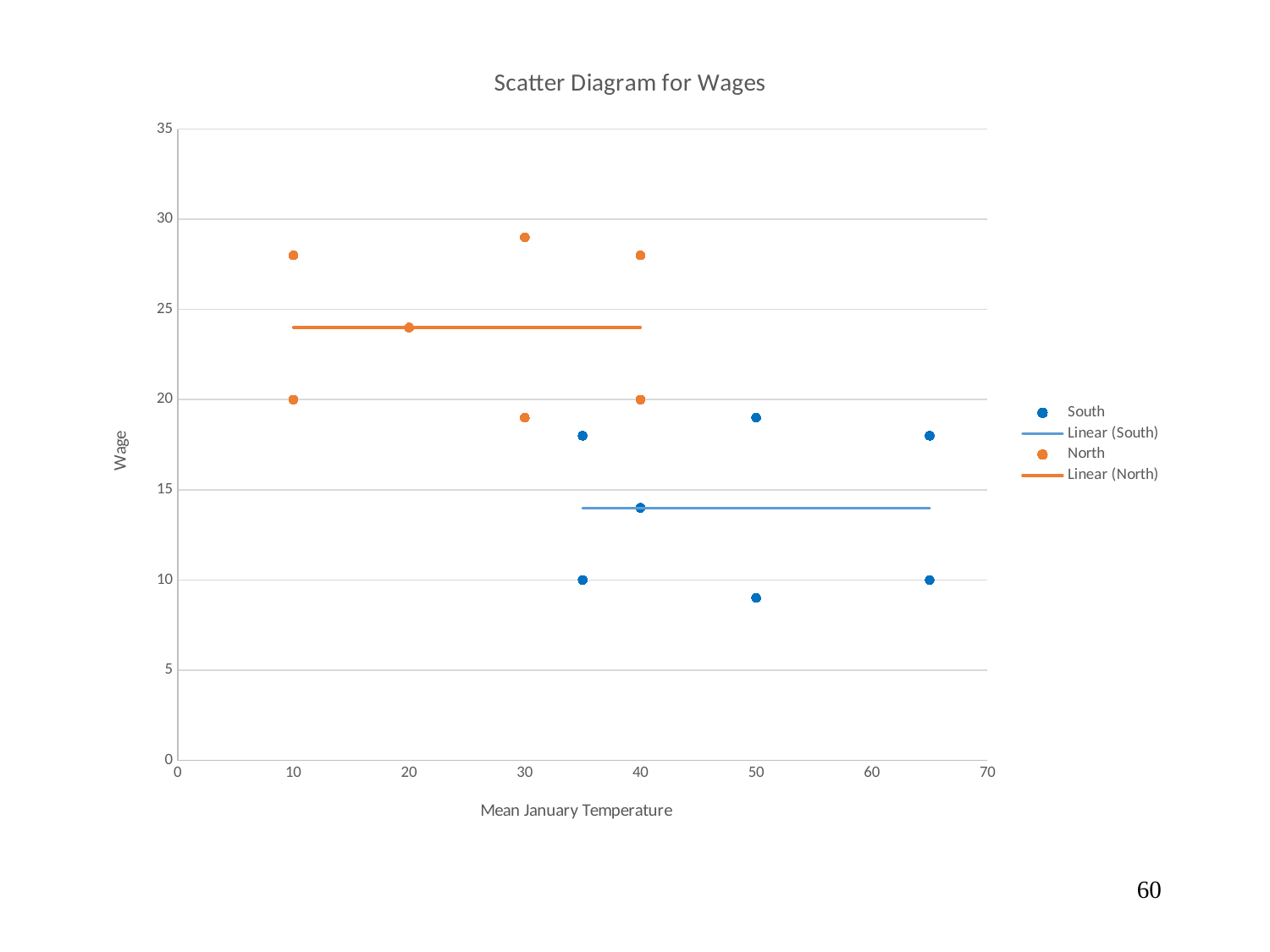
Which trendline sits higher on the chart, Linear (South) or Linear (North)? Linear (North) Which series contains the highest wage value plotted on the chart? North How many North data points are plotted? 7 What is the title of the chart? Scatter Diagram for Wages How many South data points are plotted? 7 Which series contains the lowest wage value plotted on the chart? South Is the wage of the highest North point (at a mean January temperature of 30) greater or less than 25? greater Is the Linear (North) trendline above or below a wage of 20? above What kind of chart is shown on the slide? Scatter chart Is the wage of the lowest South point (at a mean January temperature of 50) greater or less than 10? less What is the label of the horizontal axis? Mean January Temperature How many entries does the legend list? 4